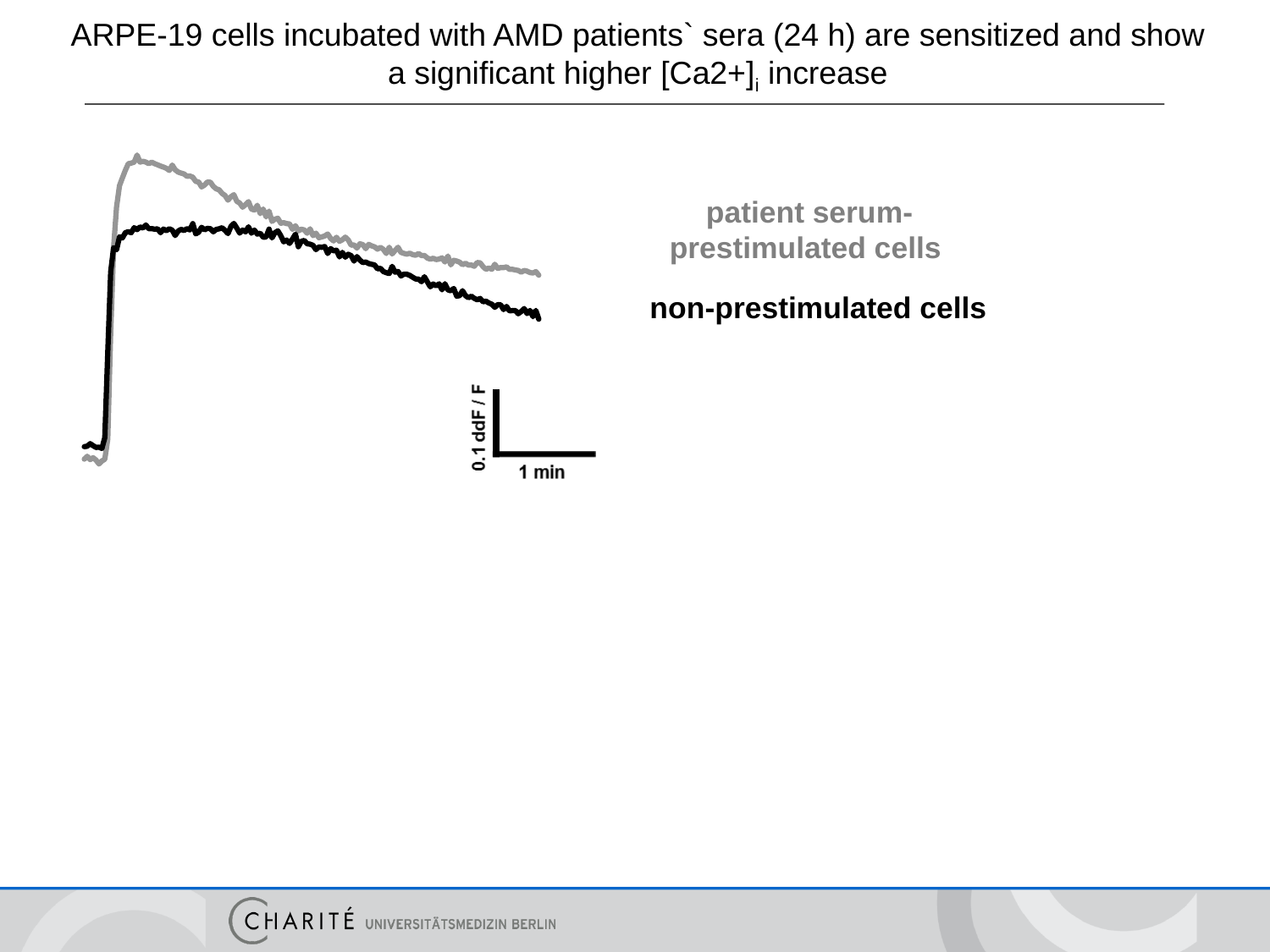
How many traces (series) are plotted on the chart? 2 What kind of chart is shown on the slide? line chart At the start of the recording, before the sharp rise, are the two traces at a low or high level? low Which trace reaches the higher peak: patient serum-prestimulated cells or non-prestimulated cells? patient serum-prestimulated cells Which series has the lower peak value? non-prestimulated cells What time span does the horizontal scale bar represent? 1 min Which colour is used for the patient serum-prestimulated cells trace? grey After the initial sharp rise, do the traces rise or fall over time? fall Which series is drawn in black? non-prestimulated cells What does the vertical scale bar represent? 0.1 ddF / F